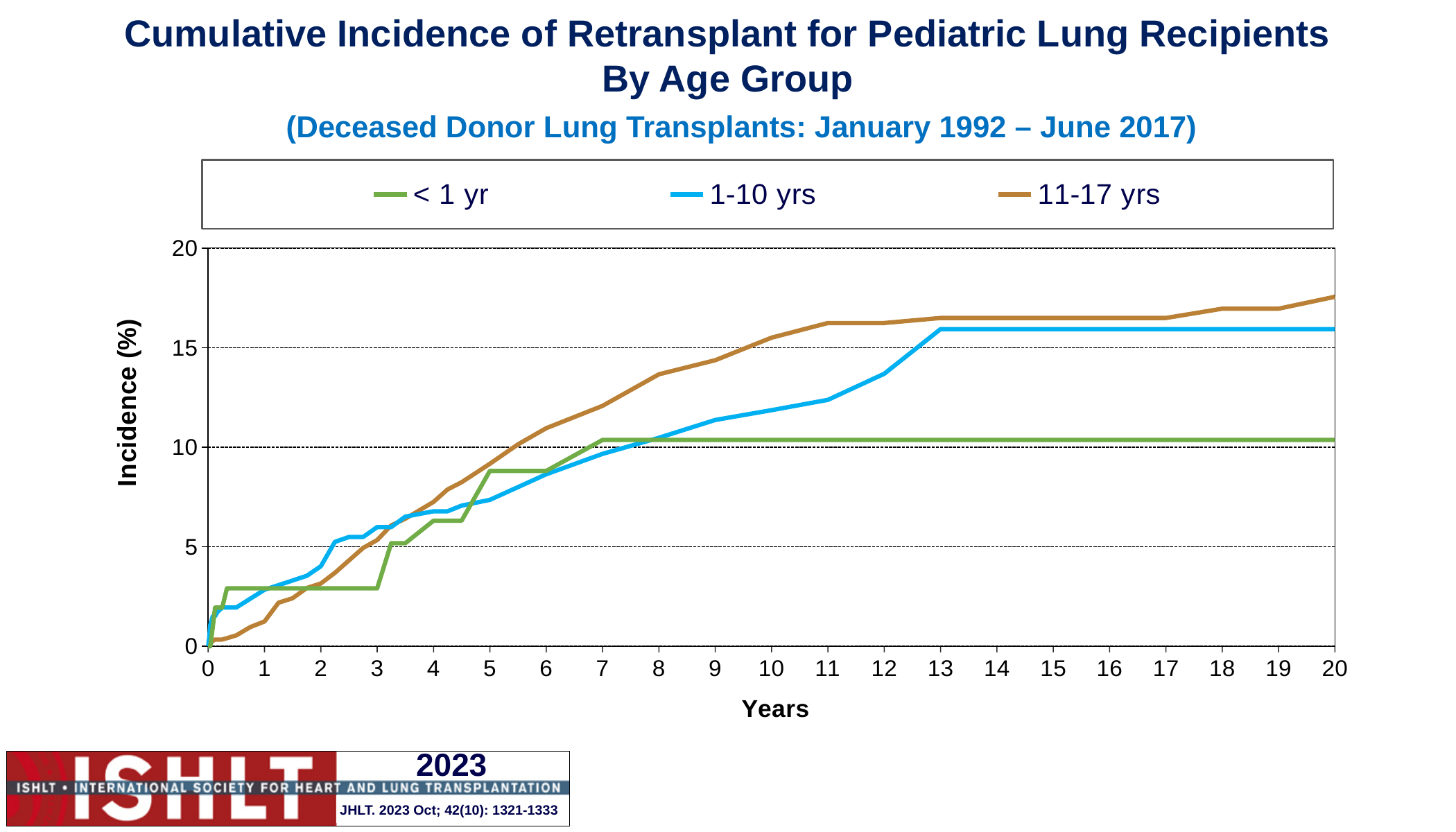
Is the value for the < 1 yr group at 15 years greater or less than 15? less Which age group has the highest cumulative incidence of retransplant at 20 years? 11-17 yrs Which age group has the lowest cumulative incidence of retransplant at 20 years? < 1 yr Is the value for the 11-17 yrs group at 20 years greater or less than 15? greater What are the three age groups listed in the legend? < 1 yr, 1-10 yrs, 11-17 yrs At 10 years, which group has the larger cumulative incidence: 11-17 yrs or 1-10 yrs? 11-17 yrs What is the label of the y axis? Incidence (%) Does the cumulative incidence for the 11-17 yrs group rise or fall as years increase? rise Is the value for the 1-10 yrs group at 10 years greater or less than 10? greater What kind of chart is shown on the slide? line chart At 3 years, which group has the larger cumulative incidence: 1-10 yrs or < 1 yr? 1-10 yrs How many series does the legend list? 3